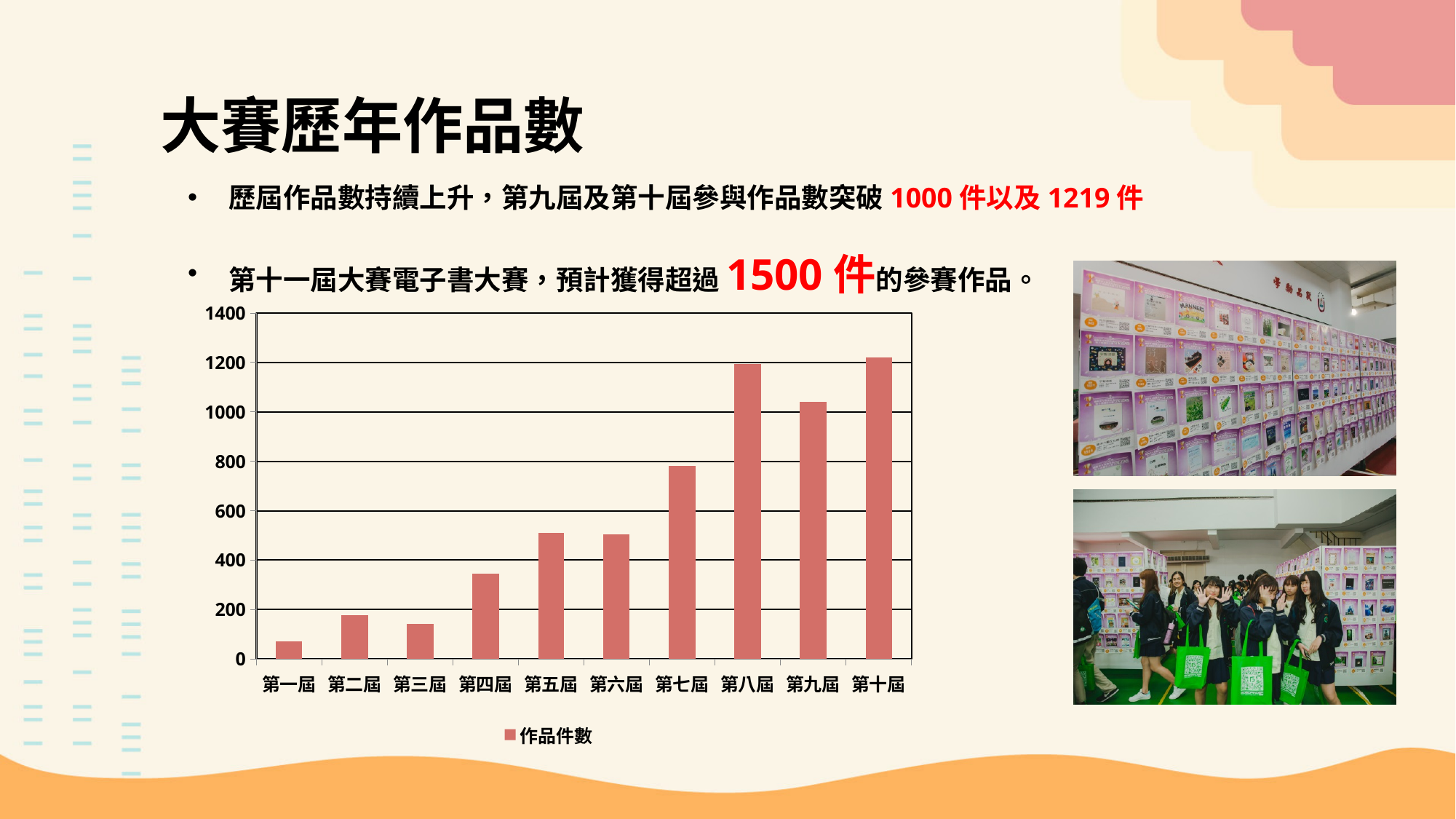
What kind of chart is shown on the slide? bar chart Is the value for 第九屆 greater or less than 1200? less Do the values generally rise or fall from 第一屆 to 第十屆? rise Which is larger, the value for 第八屆 or the value for 第九屆? 第八屆 How many series does the chart's legend list? 1 Is the value for 第七屆 greater or less than 600? greater How many categories (competition editions) are shown on the x axis of the chart? 10 Is the value for 第八屆 greater or less than 1000? greater Which edition has the lowest number of works in the chart? 第一屆 What is the name of the series shown in the chart's legend? 作品件數